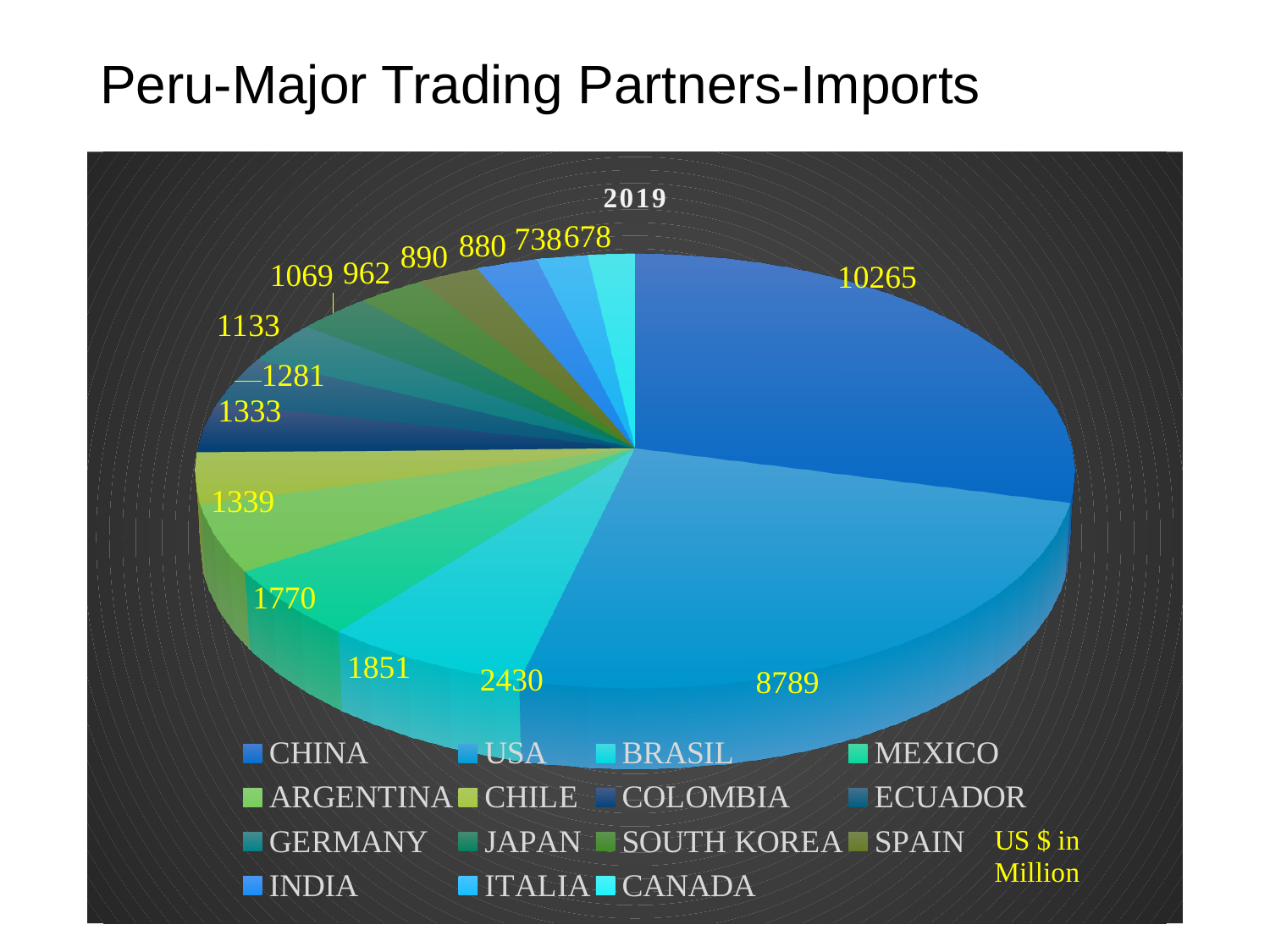
Which trading partner has the smallest slice of the pie? CANADA What is the value shown for BRASIL? 2430 What year is shown as the chart title? 2019 What is the import value for CHINA in the pie chart? 10265 What is the value shown for CANADA? 678 How many trading partners are listed in the legend? 15 Which trading partner has the largest slice of the pie? CHINA What type of chart is shown on the slide? Pie chart Which is larger, the value for MEXICO or the value for ARGENTINA? MEXICO What unit are the values in, according to the note on the chart? US $ in Million What is the difference between the values for CHINA and USA? 1476 What is the import value for USA? 8789